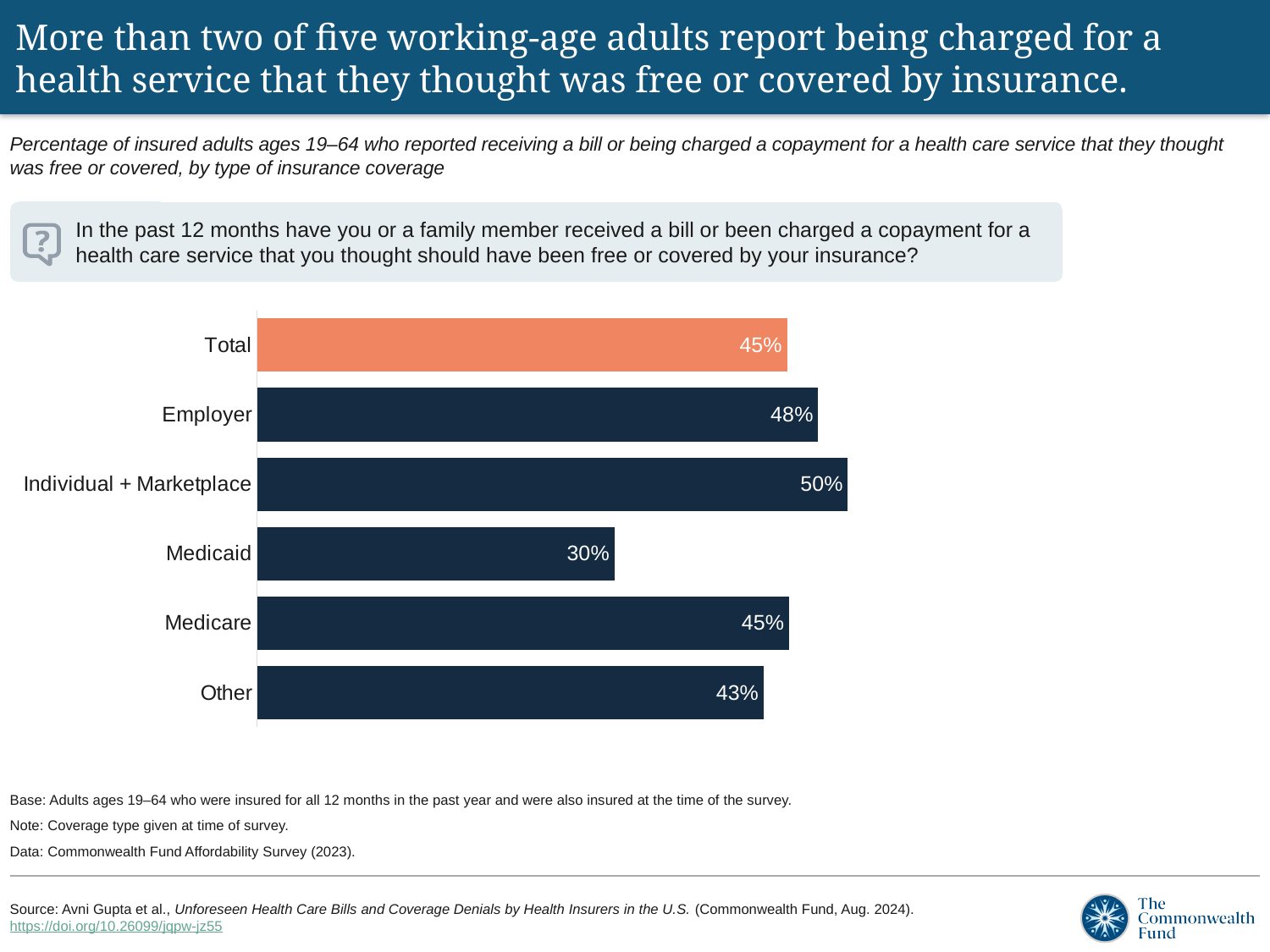
What percentage is shown for Employer coverage? 48% What kind of chart is shown on the slide? Bar chart What is the value for Individual + Marketplace? 50% Which coverage type has the lowest percentage? Medicaid Which bar is shown in a different colour (orange) from the others? Total What percentage is shown for the Total bar? 45% What is the value for Medicaid? 30% How many bars are shown in the chart? 6 What is the difference between the Employer value and the Medicare value? 3 percentage points Which is larger, the value for Employer or the value for Other? Employer What is the difference between the Individual + Marketplace value and the Medicaid value? 20 percentage points Which coverage type has the highest percentage? Individual + Marketplace